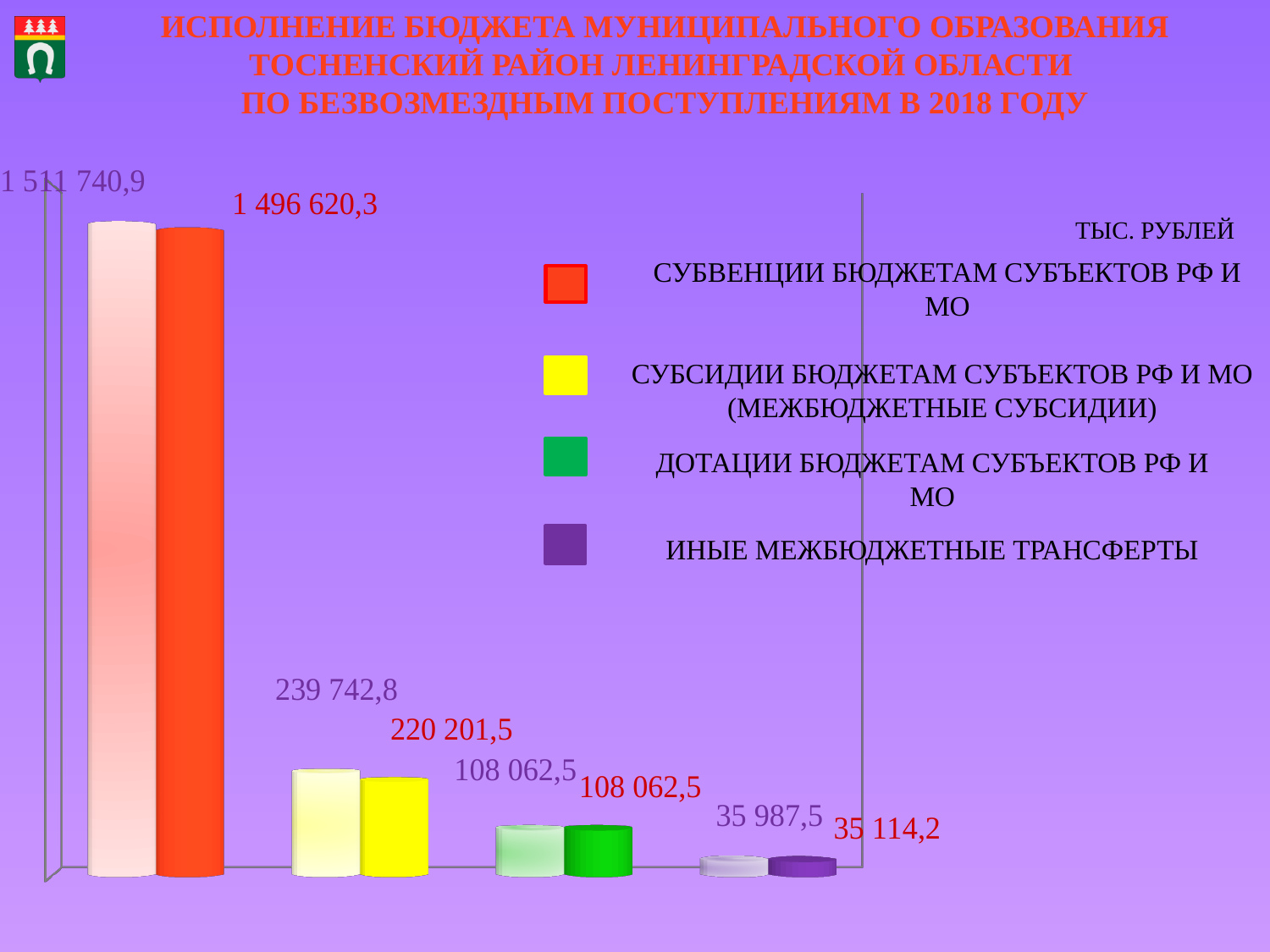
What is the value shown in red for ИНЫЕ МЕЖБЮДЖЕТНЫЕ ТРАНСФЕРТЫ? 35 114,2 In what units are the chart values given, according to the slide? ТЫС. РУБЛЕЙ Which category has the highest values in the chart? СУБВЕНЦИИ БЮДЖЕТАМ СУБЪЕКТОВ РФ И МО What is the value shown in red for СУБВЕНЦИИ БЮДЖЕТАМ СУБЪЕКТОВ РФ И МО? 1 496 620,3 Which is larger for СУБСИДИИ БЮДЖЕТАМ СУБЪЕКТОВ РФ И МО: the grey value or the red value? the grey value (239 742,8) What type of chart is shown on the slide? bar chart What is the value shown in grey (the lighter left bar) for СУБВЕНЦИИ БЮДЖЕТАМ СУБЪЕКТОВ РФ И МО? 1 511 740,9 How many categories are shown in the chart? 4 What is the value shown in grey (the lighter left bar) for ДОТАЦИИ БЮДЖЕТАМ СУБЪЕКТОВ РФ И МО? 108 062,5 What is the value shown in red for СУБСИДИИ БЮДЖЕТАМ СУБЪЕКТОВ РФ И МО (МЕЖБЮДЖЕТНЫЕ СУБСИДИИ)? 220 201,5 What is the difference between the grey value (1 511 740,9) and the red value (1 496 620,3) for СУБВЕНЦИИ БЮДЖЕТАМ СУБЪЕКТОВ РФ И МО? 15 120,6 Which category has the lowest values in the chart? ИНЫЕ МЕЖБЮДЖЕТНЫЕ ТРАНСФЕРТЫ